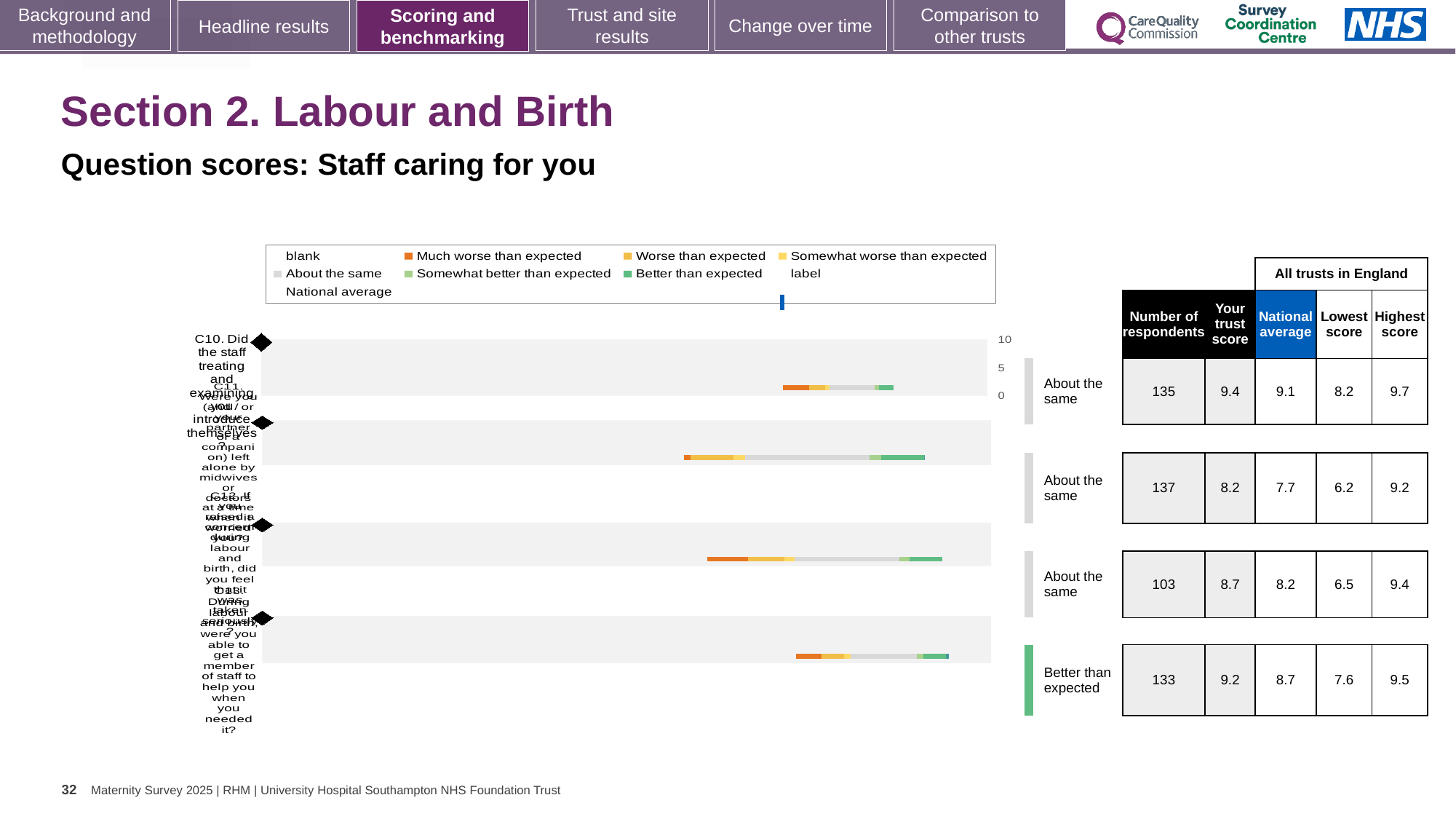
Which question row has the lowest 'Lowest score' value? The second row (C11), 6.2 Which question row is rated 'Better than expected'? The fourth row (C13) For the second question row (C11), what is the difference between the highest score and the lowest score? 3.0 Which question row has the highest 'Your trust score'? The first row (C10), 9.4 What is the national average for the second question row (C11)? 7.7 What is the 'Your trust score' value for the first question row (C10)? 9.4 For the fourth question row (C13), how much higher is the trust score than the national average? 0.5 In the table next to the chart, how many respondents are listed for the first question row (C10)? 135 For the second question row (C11), which is larger: the trust score or the national average? The trust score (8.2) What is the highest score among all trusts in England for the third question row (C12)? 9.4 What kind of chart is shown on the slide? Bar chart How many question rows are plotted in the chart? 4